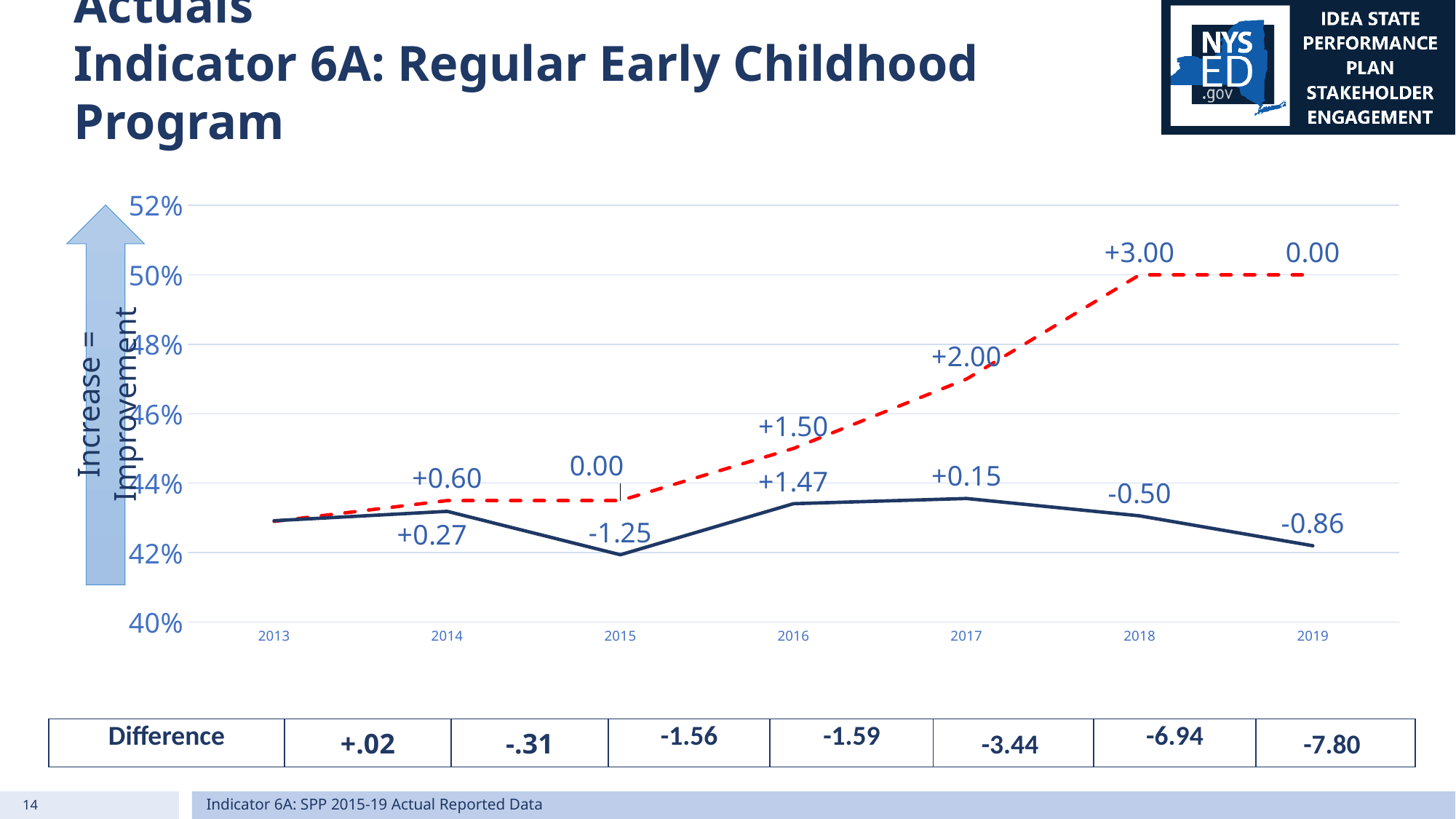
How many years are plotted along the x axis of the chart? 7 What is the data label shown on the red dashed line at 2018? +3.00 What is the data label shown on the dark blue solid line at 2019? -0.86 What is the Difference value shown in the table below the chart for the last column (2019)? -7.80 At 2019, which line is higher: the red dashed line or the dark blue solid line? the red dashed line Is the value of the red dashed line at 2017 greater or less than 48%? less What is the data label shown on the dark blue solid line at 2015? -1.25 What is the data label shown on the red dashed line at 2016? +1.50 What is the data label shown on the dark blue solid line at 2016? +1.47 Is the value of the dark blue solid line at 2017 greater or less than 44%? less What kind of chart is shown on the slide? line chart Does the red dashed line rise or fall from 2015 to 2018? rise